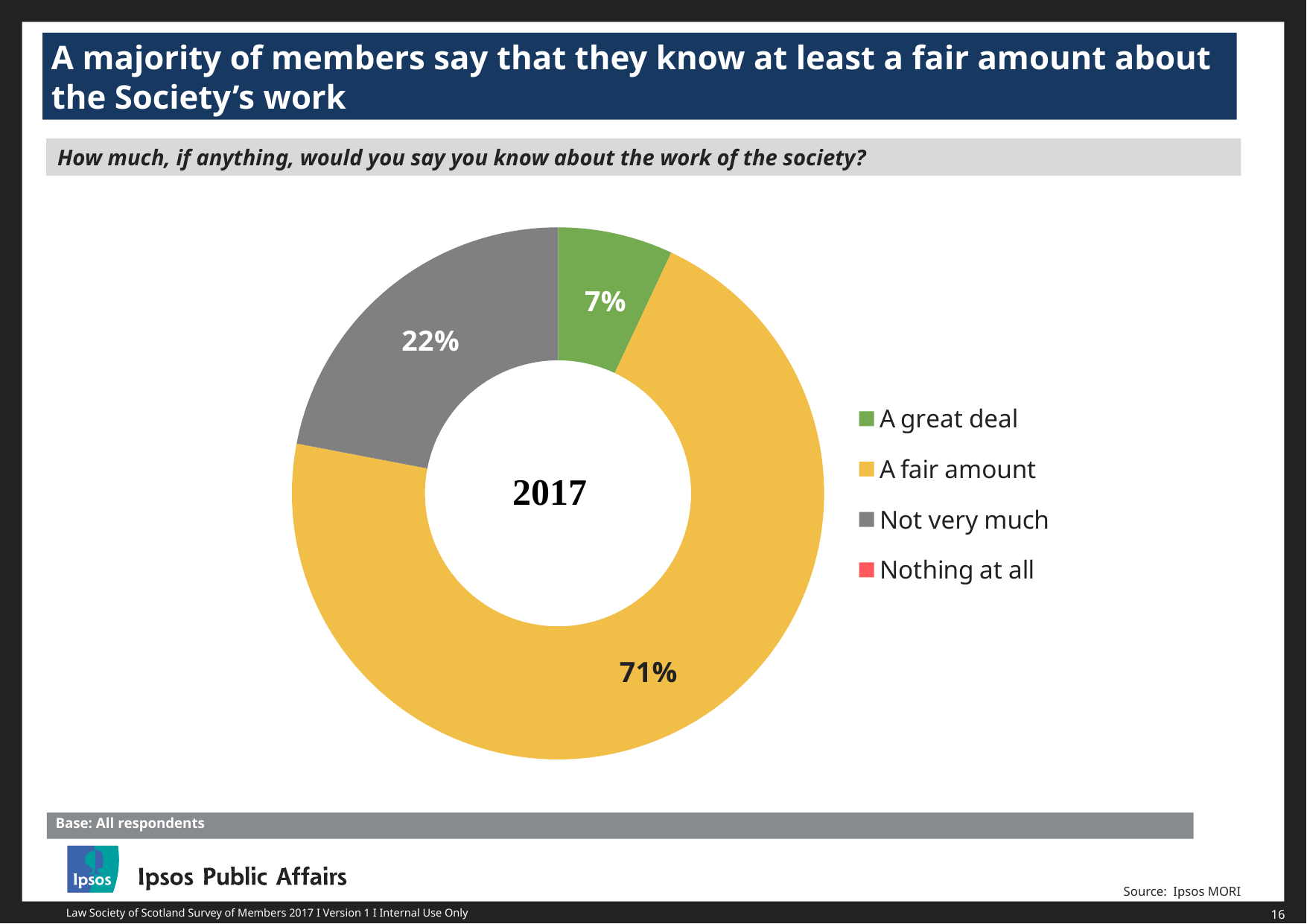
What year is shown in the centre of the chart? 2017 What colour represents 'A fair amount' in the chart? Yellow What percentage of members say they know a great deal about the work of the society? 7% Which labelled response category has the smallest share of the chart? A great deal Which response category has the largest share of the chart? A fair amount What percentage of members say they know a fair amount about the work of the society? 71% What percentage of members say they know not very much about the work of the society? 22% Which is larger: the share for 'Not very much' or the share for 'A great deal'? Not very much How many response categories does the legend list? 4 What is the difference in percentage points between 'Not very much' and 'A great deal'? 15 What is the difference in percentage points between 'A fair amount' and 'Not very much'? 49 What kind of chart is shown on the slide? Pie chart (doughnut)